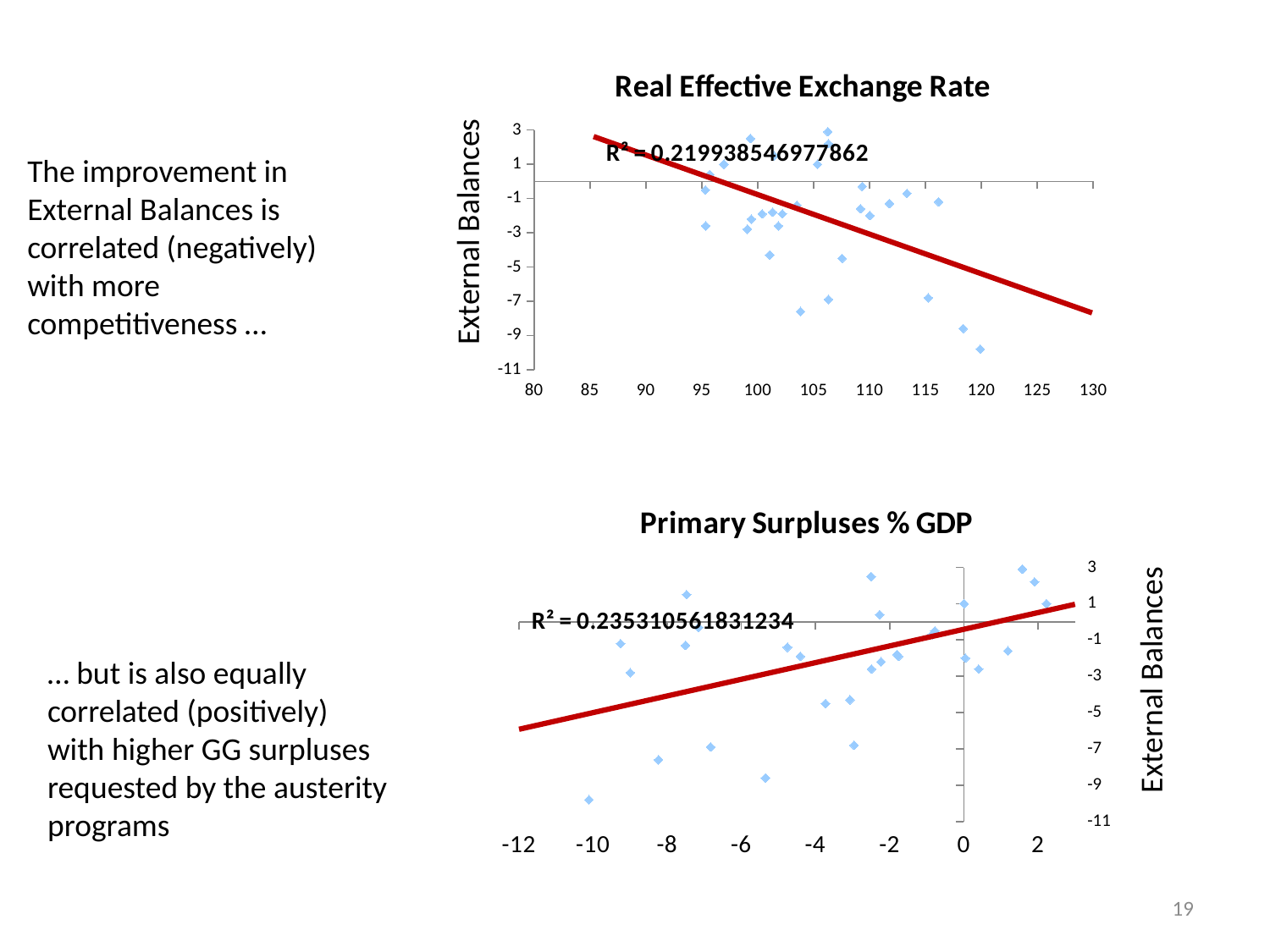
In the top chart 'Real Effective Exchange Rate', does the trend line rise or fall as the x-axis values increase? fall Which chart has the larger printed R² value, 'Real Effective Exchange Rate' or 'Primary Surpluses % GDP'? Primary Surpluses % GDP In the bottom chart 'Primary Surpluses % GDP', does the trend line rise or fall as the x-axis values increase? rise What R² value is printed on the bottom chart 'Primary Surpluses % GDP'? 0.235310561831234 What kind of chart is the top chart titled 'Real Effective Exchange Rate'? scatter chart What R² value is printed on the top chart 'Real Effective Exchange Rate'? 0.219938546977862 What kind of chart is the bottom chart titled 'Primary Surpluses % GDP'? scatter chart How many charts are shown on the slide? 2 What is the title of the bottom chart on the slide? Primary Surpluses % GDP In the top chart 'Real Effective Exchange Rate', is the lowest plotted point greater or less than -9 on the vertical axis? less What is the label on the vertical axis of the top chart 'Real Effective Exchange Rate'? External Balances In the bottom chart 'Primary Surpluses % GDP', is the lowest plotted point greater or less than -9 on the vertical axis? less